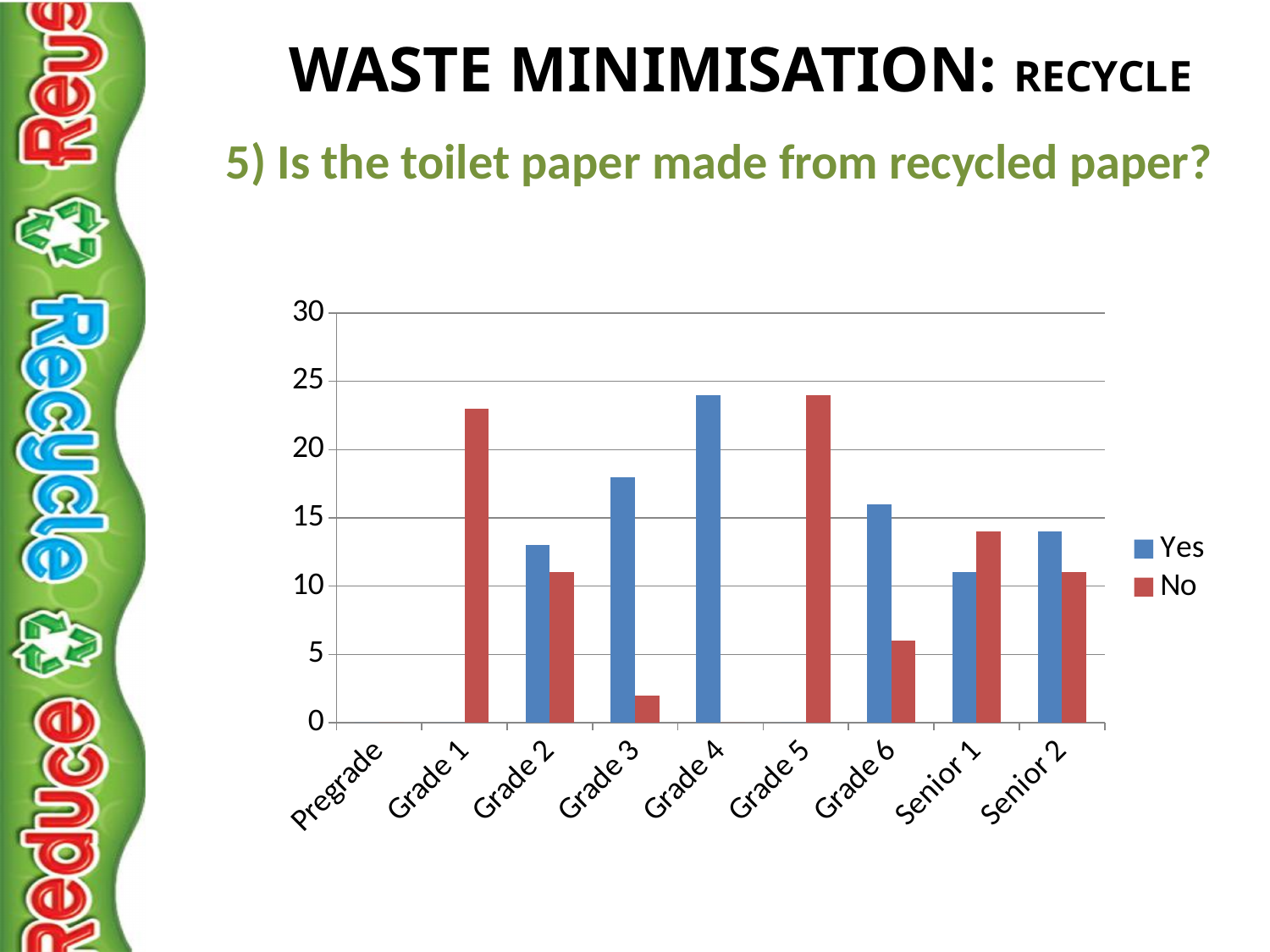
Is the 'Yes' value for Grade 4 greater or less than 20? greater Is the 'No' value for Grade 1 greater or less than 20? greater For Senior 1, which is larger, the 'Yes' value or the 'No' value? No How many series does the legend list? 2 For Grade 3, which is larger, the 'Yes' value or the 'No' value? Yes Which category has the highest 'Yes' value? Grade 4 How many grade categories are shown on the x axis? 9 For Grade 6, which is larger, the 'Yes' value or the 'No' value? Yes What kind of chart is shown on the slide? bar chart Among the categories with a visible 'No' bar, which has the lowest 'No' value? Grade 3 What colour are the 'No' bars in the chart? red Is the 'No' value for Grade 3 greater or less than 5? less